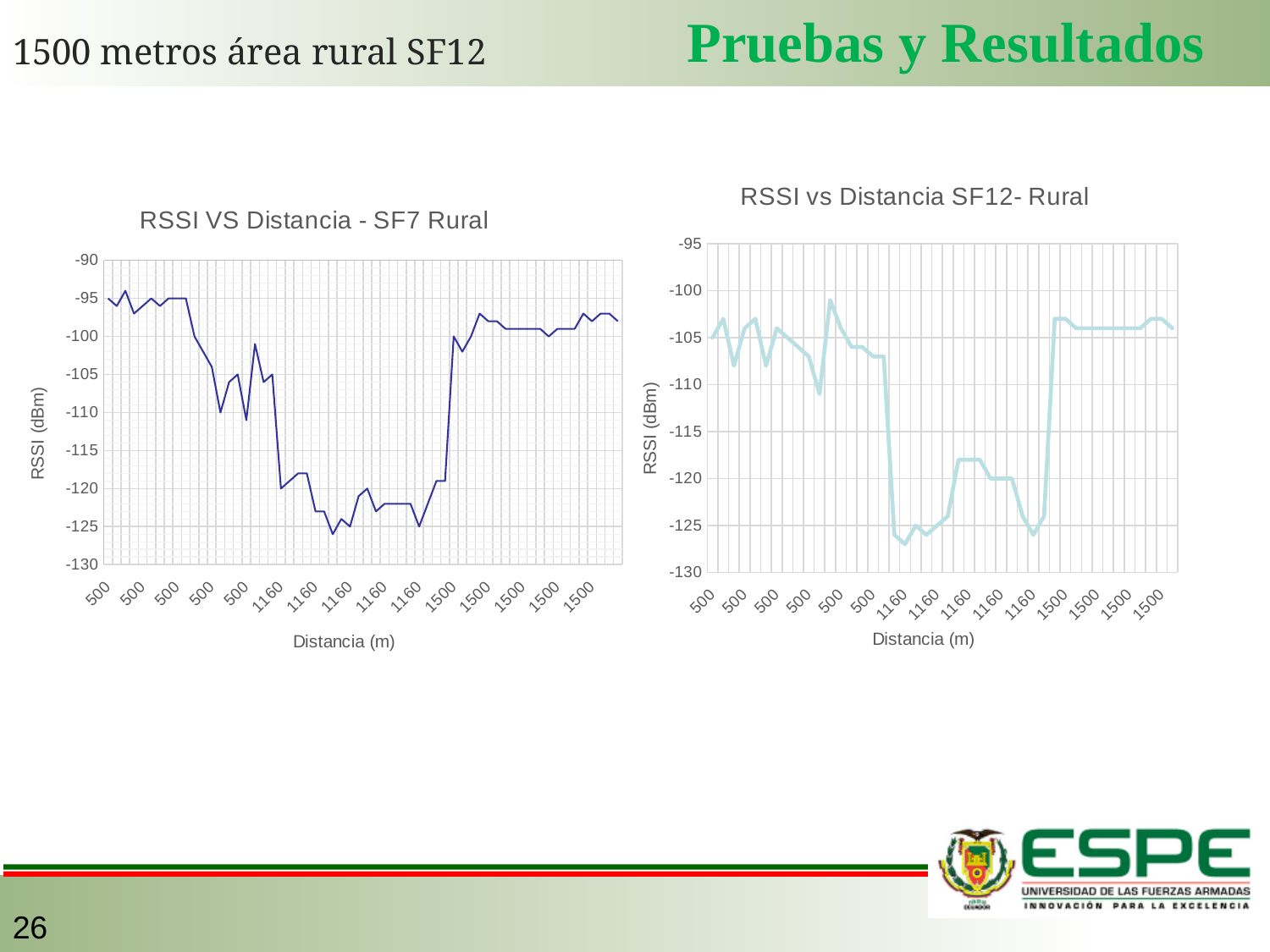
In the right chart "RSSI vs Distancia SF12- Rural", is the highest plotted RSSI value greater or less than -105? greater How many charts are shown on the slide? 2 What kind of chart is the right chart titled "RSSI vs Distancia SF12- Rural"? Line chart In the right chart "RSSI vs Distancia SF12- Rural", are the RSSI values at the 1500 m points higher or lower than those at the 1160 m points? higher What is the y-axis label of the left chart "RSSI VS Distancia - SF7 Rural"? RSSI (dBm) What is the x-axis label of the right chart "RSSI vs Distancia SF12- Rural"? Distancia (m) In the left chart "RSSI VS Distancia - SF7 Rural", are the RSSI values at the 500 m points higher or lower than those at the 1160 m points? higher In the right chart "RSSI vs Distancia SF12- Rural", is the lowest plotted RSSI value greater or less than -120? less In the left chart "RSSI VS Distancia - SF7 Rural", is the highest plotted RSSI value greater or less than -100? greater What kind of chart is the left chart titled "RSSI VS Distancia - SF7 Rural"? Line chart In the right chart "RSSI vs Distancia SF12- Rural", do the RSSI values rise or fall when moving from the 500 m points to the 1160 m points along the x axis? fall